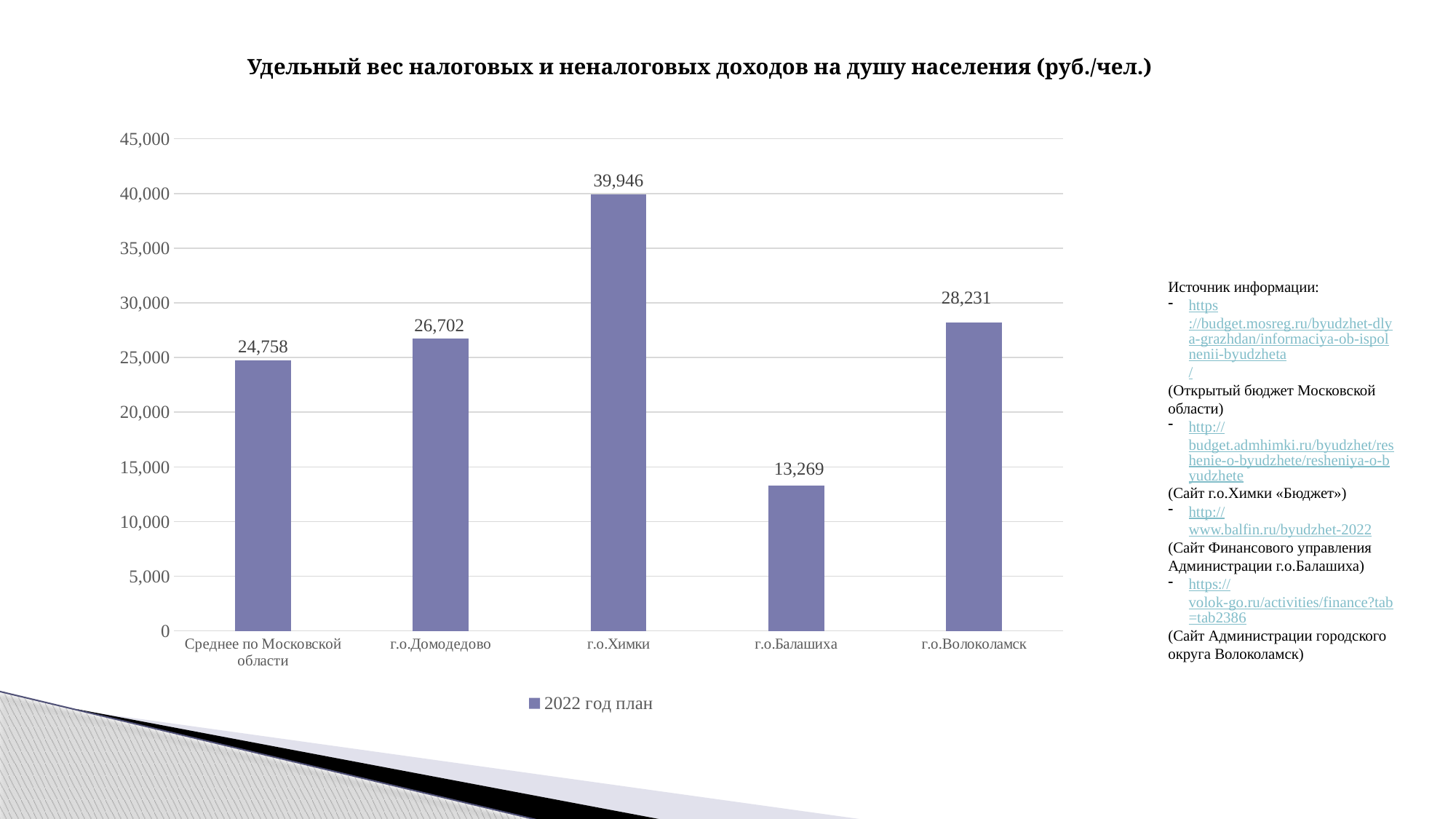
What is the value for г.о.Балашиха? 13,269 Which category has the highest value? г.о.Химки What kind of chart is shown? bar chart What is the value for Среднее по Московской области? 24,758 What is the difference between the values for г.о.Химки and г.о.Балашиха? 26,677 Which is larger, the value for г.о.Домодедово or the value for г.о.Волоколамск? г.о.Волоколамск How many categories are shown on the x axis? 5 Is the value for г.о.Балашиха greater or less than 15,000? less What is the value for г.о.Химки? 39,946 What is the difference between the values for г.о.Волоколамск and г.о.Домодедово? 1,529 How many series does the legend list? 1 Which category has the lowest value? г.о.Балашиха